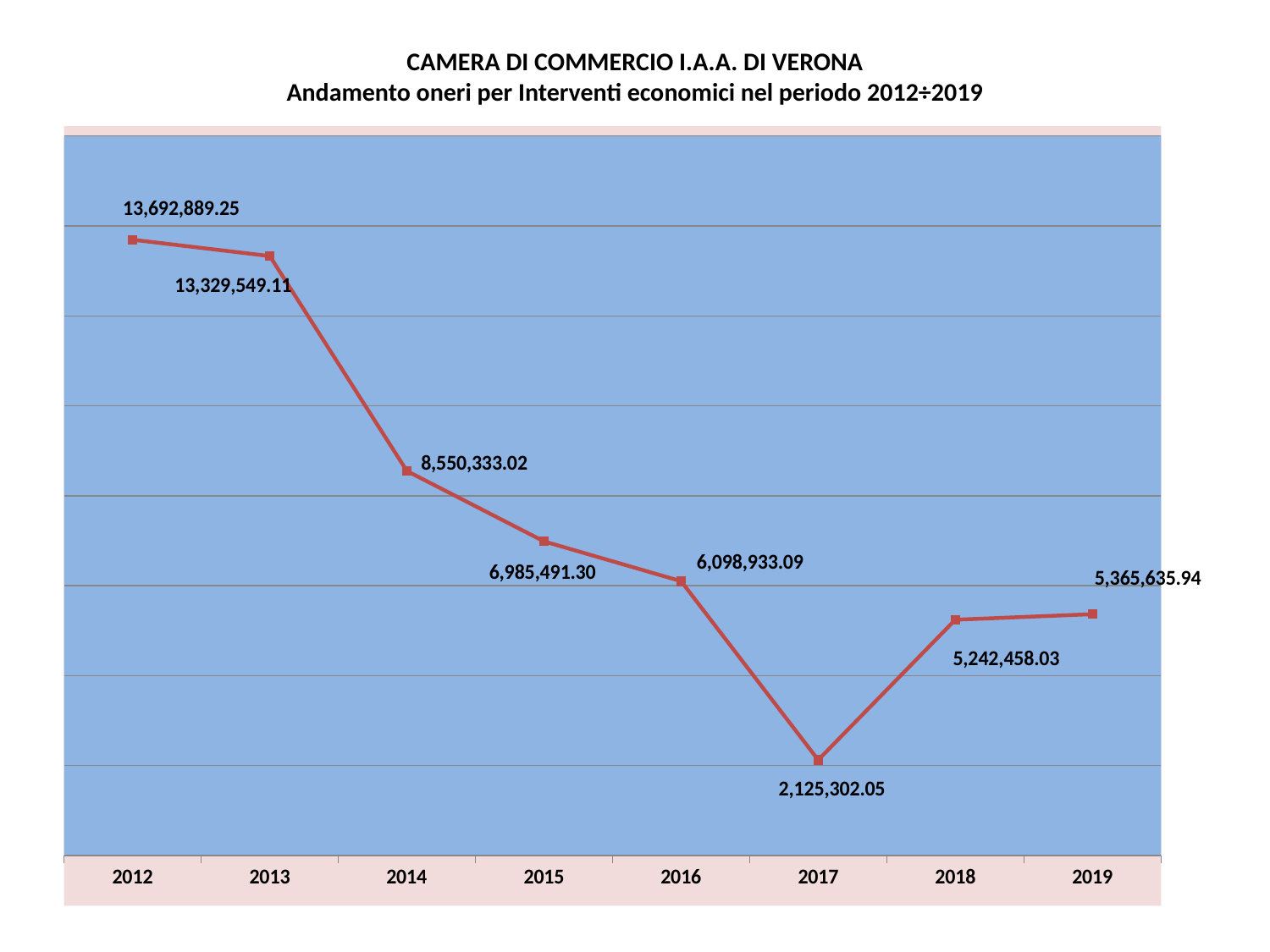
Do the values rise or fall from 2012 to 2017? fall What kind of chart is shown? line chart Which year has the lowest value? 2017 What is the value for 2012? 13,692,889.25 What is the value for 2019? 5,365,635.94 Which year has the highest value? 2012 What is the value for 2014? 8,550,333.02 How many years are plotted on the chart? 8 What is the difference between the values for 2012 and 2013? 363,340.14 Which is larger, the value for 2015 or the value for 2016? 2015 What is the difference between the values for 2019 and 2018? 123,177.91 What is the value for 2017? 2,125,302.05